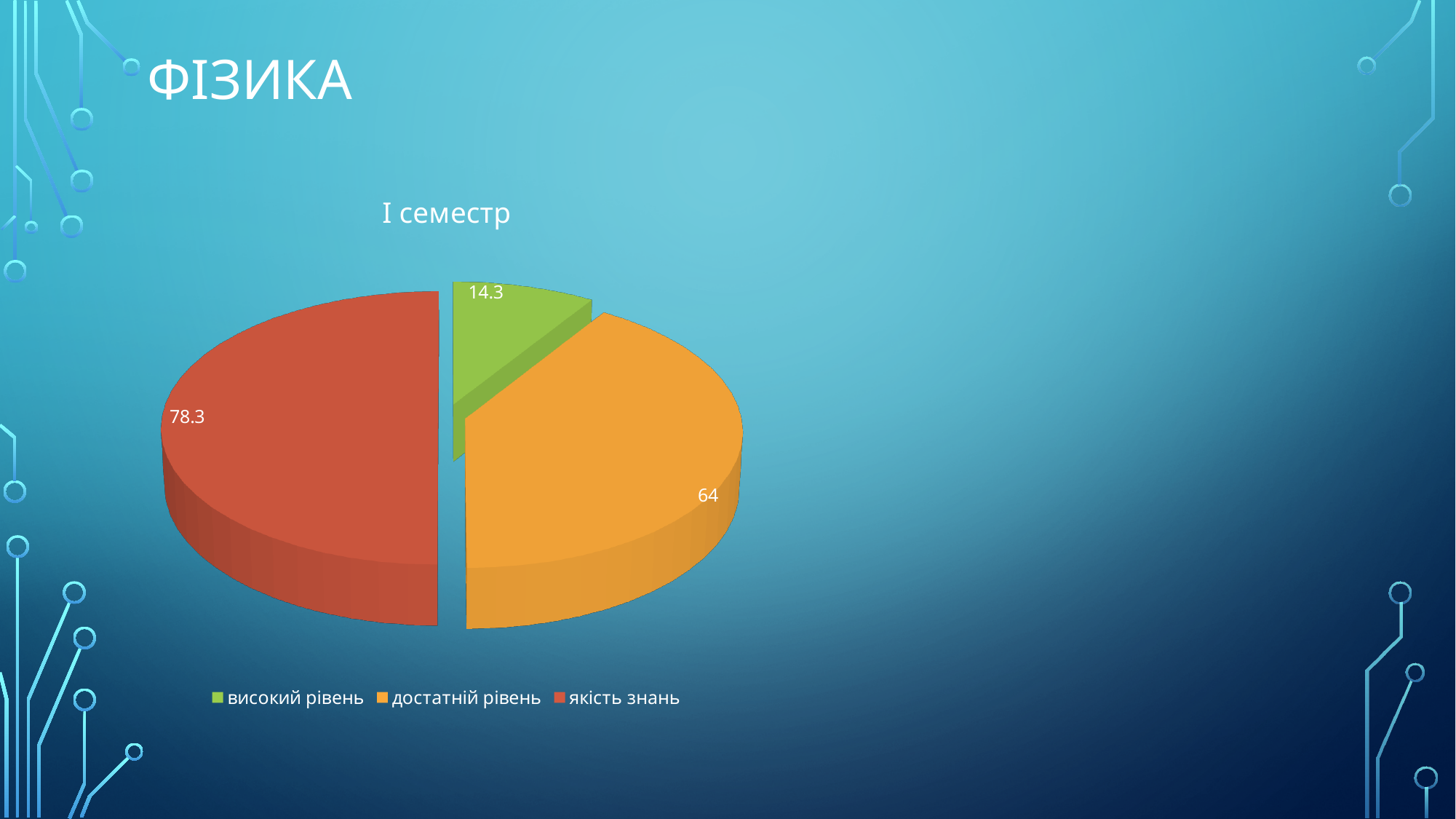
What is the value for якість знань? 78.3 What is the difference between the values for якість знань and достатній рівень? 14.3 What is the title of the chart? І семестр What is the value for достатній рівень? 64 How many entries does the legend list? 3 What is the difference between the values for достатній рівень and високий рівень? 49.7 Which is larger, the value for достатній рівень or the value for високий рівень? достатній рівень What type of chart is shown on the slide? pie chart How many slices does the pie chart have? 3 Which category has the largest value? якість знань What is the value for високий рівень? 14.3 Which category has the smallest value? високий рівень